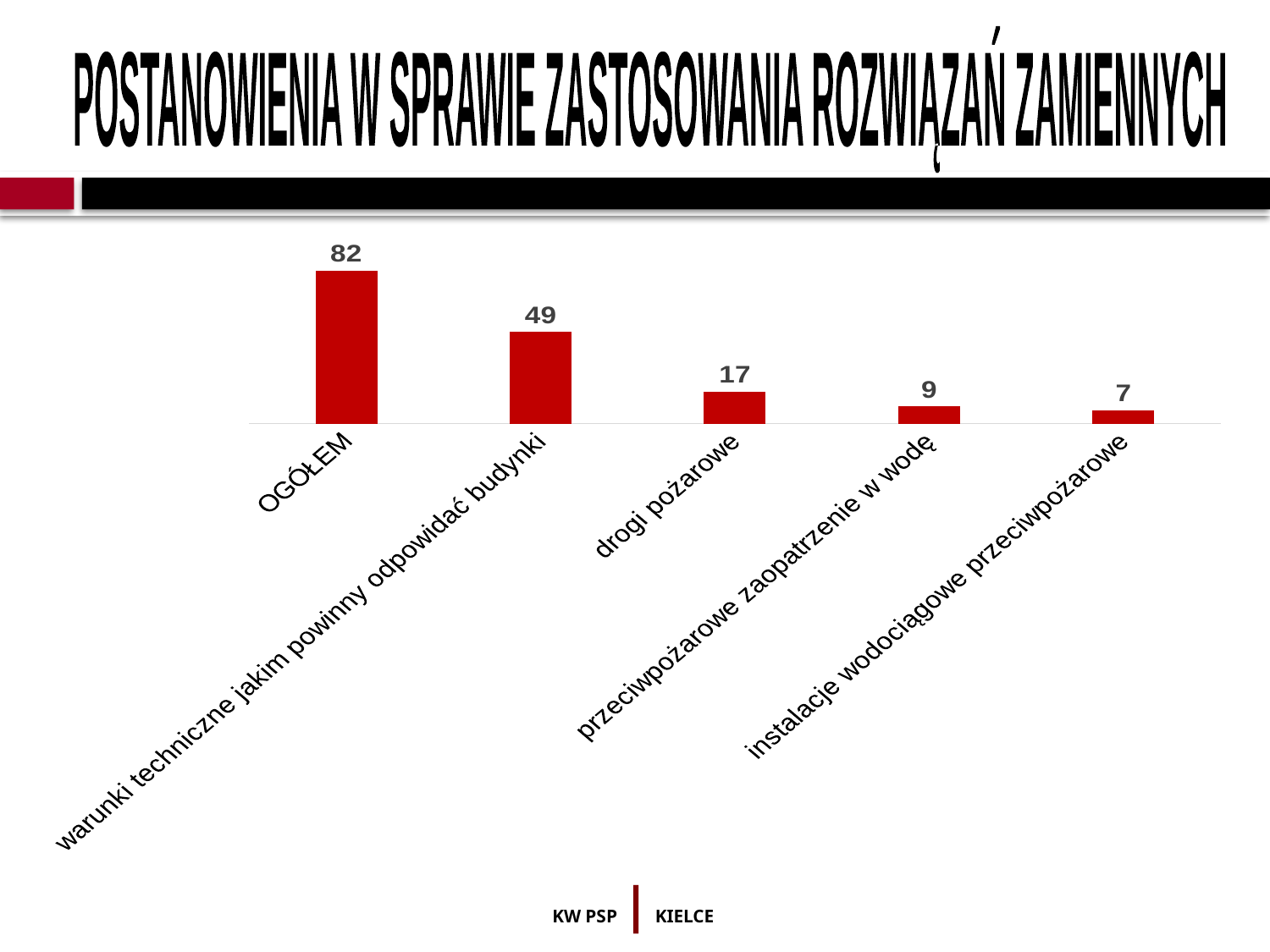
What is the difference between the values for OGÓŁEM and warunki techniczne jakim powinny odpowiadać budynki? 33 What is the value for drogi pożarowe? 17 What is the value for instalacje wodociągowe przeciwpożarowe? 7 What kind of chart is shown on the slide? bar chart Which category has the lowest value? instalacje wodociągowe przeciwpożarowe Do the values rise or fall from left to right across the categories? fall What is the value for przeciwpożarowe zaopatrzenie w wodę? 9 Which is larger: the value for drogi pożarowe or the value for instalacje wodociągowe przeciwpożarowe? drogi pożarowe What is the value for OGÓŁEM? 82 What is the difference between the values for drogi pożarowe and przeciwpożarowe zaopatrzenie w wodę? 8 Which category has the highest value? OGÓŁEM How many categories are shown in the chart? 5